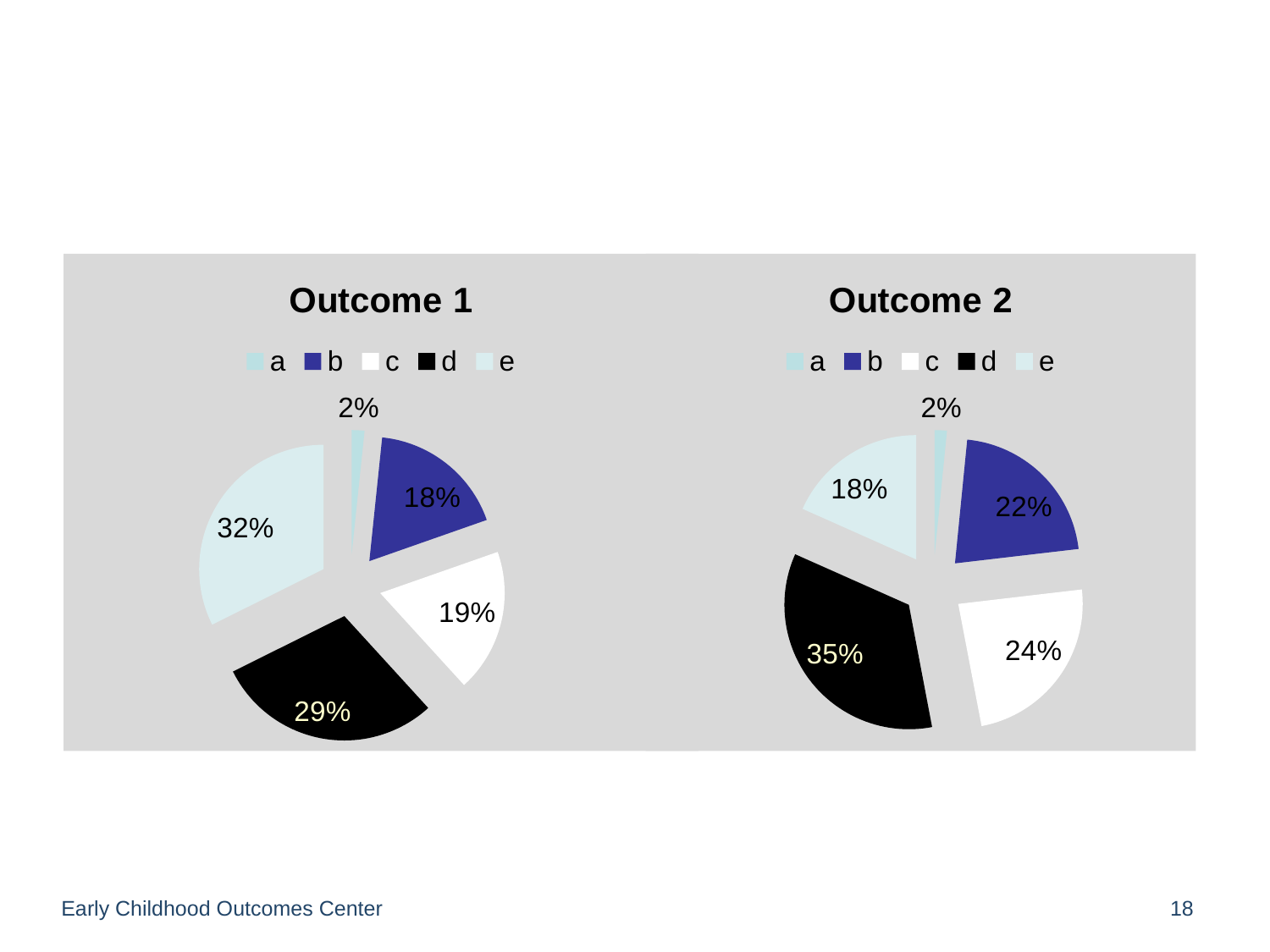
In the Outcome 1 chart, what percentage is shown for category e? 32% In the Outcome 2 chart, which category has the smallest slice? a In the Outcome 2 chart, what is the difference in percentage points between category d and category e? 17 In the Outcome 1 chart, what percentage is shown for category d? 29% In the Outcome 1 chart, which category has the largest slice? e How many slices does the Outcome 1 pie chart have? 5 Which is larger in the Outcome 1 chart: the slice for category b or the slice for category d? d In the Outcome 2 chart, what percentage is shown for category c? 24% In the Outcome 2 chart, which category has the largest slice? d What type of chart is used for Outcome 2? Pie chart In the Outcome 2 chart, what percentage is shown for category b? 22% How many entries does the legend of the Outcome 1 chart list? 5